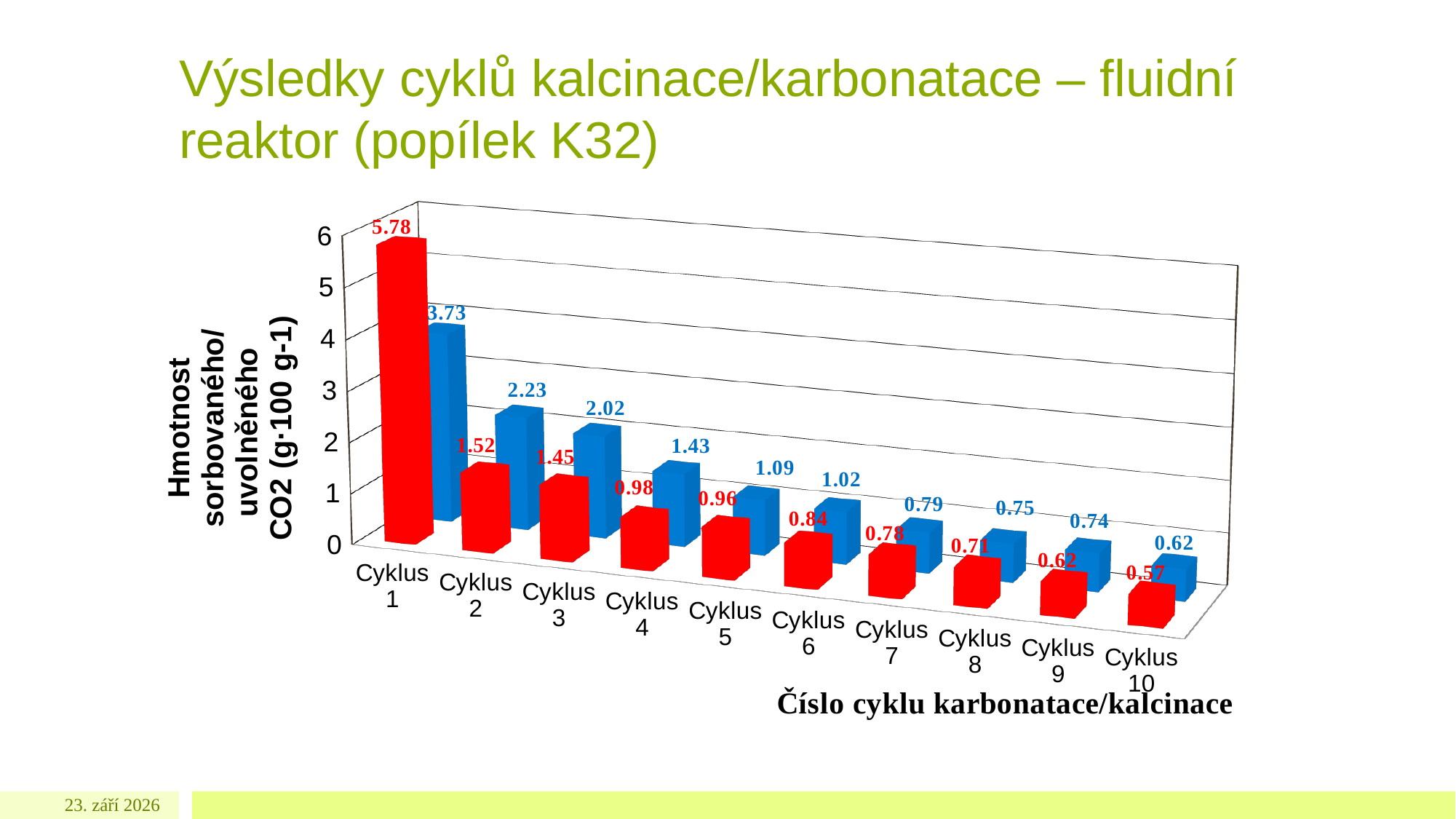
Which cycle has the highest red bar? Cyklus 1 What is the x-axis title of the chart? Číslo cyklu karbonatace/kalcinace What is the difference between the red and blue bars for Cyklus 1? 2.05 Which cycle has the lowest blue bar? Cyklus 10 Which is larger for Cyklus 4, the red bar or the blue bar? the blue bar What is the value of the red bar for Cyklus 1? 5.78 What kind of chart is shown on the slide? bar chart What is the value of the blue bar for Cyklus 7? 0.79 What is the value of the red bar for Cyklus 10? 0.57 What is the value of the blue bar for Cyklus 3? 2.02 Do the blue bar values rise or fall from Cyklus 1 to Cyklus 10? fall How many cycles are shown on the x axis? 10